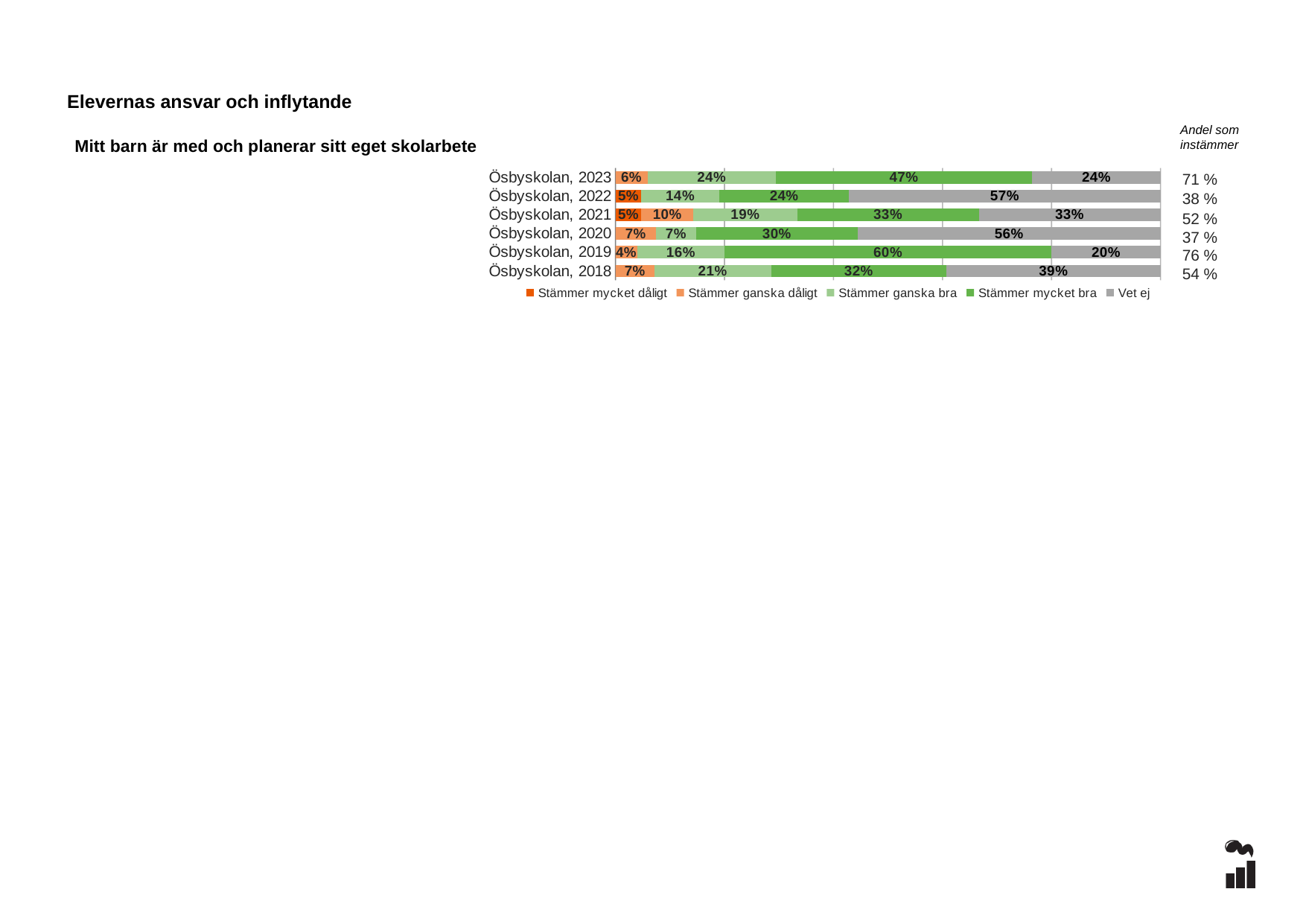
How many categories (years) are shown in the chart? 6 Which year has the highest Stämmer mycket bra value? Ösbyskolan, 2019 What is the Vet ej value for Ösbyskolan, 2022? 57% How many series does the legend list? 5 What is the Stämmer mycket bra value for Ösbyskolan, 2019? 60% What kind of chart is shown on the slide? Stacked bar chart Which year has the lowest Stämmer mycket bra value? Ösbyskolan, 2022 What is the difference between the Stämmer mycket bra values for Ösbyskolan, 2023 and Ösbyskolan, 2022? 23 percentage points Which year has the lowest 'Andel som instämmer' value? Ösbyskolan, 2020 What is the 'Andel som instämmer' value for Ösbyskolan, 2020? 37 % What is the Stämmer ganska bra value for Ösbyskolan, 2018? 21% Which has the larger Vet ej value, Ösbyskolan, 2018 or Ösbyskolan, 2021? Ösbyskolan, 2018